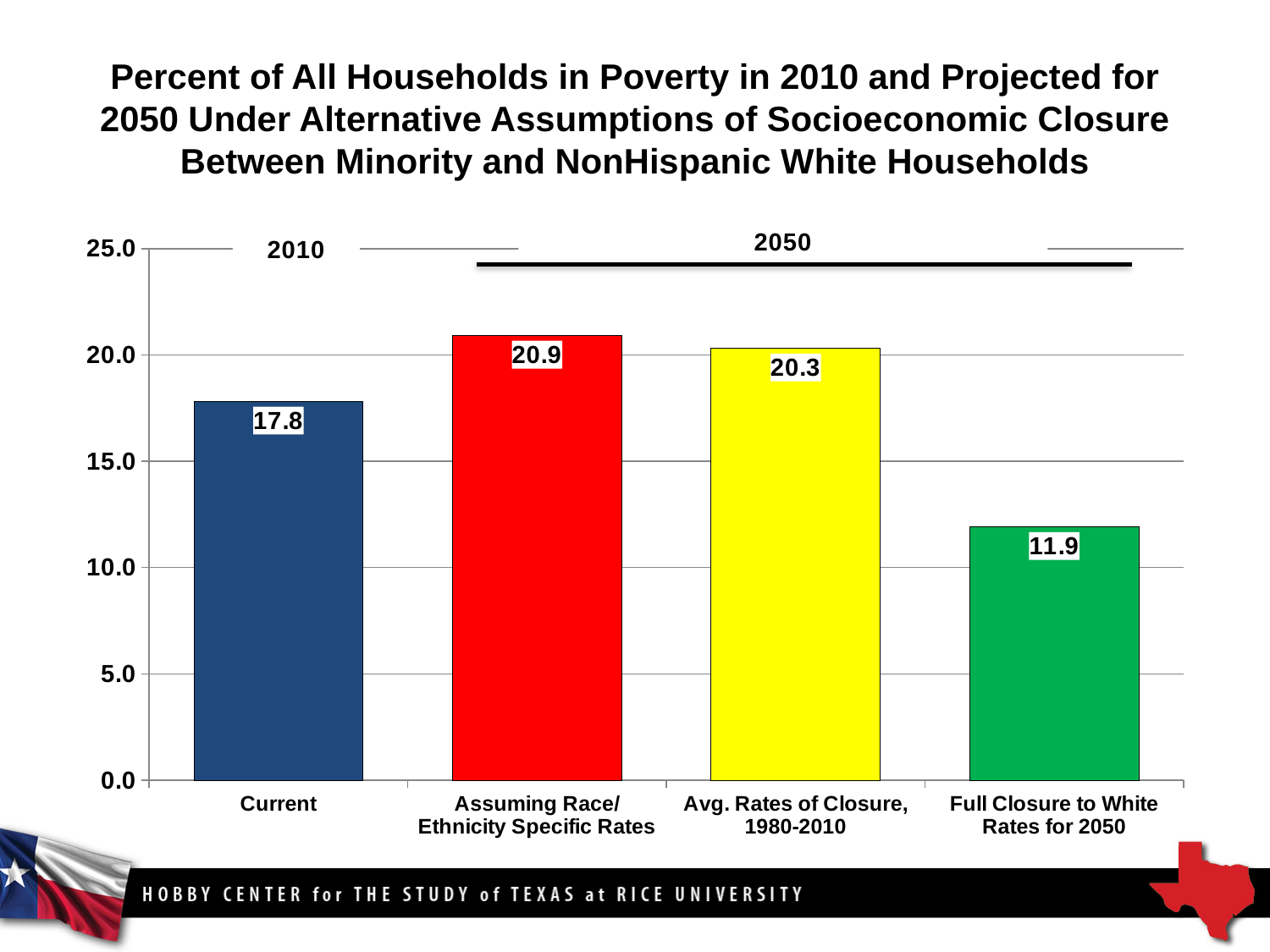
What is the difference between the Assuming Race/Ethnicity Specific Rates value and the Current value? 3.1 Is the value for Full Closure to White Rates for 2050 greater or less than 15.0? less What is the difference between the Avg. Rates of Closure, 1980-2010 value and the Full Closure to White Rates for 2050 value? 8.4 Which is larger: the value for Current or the value for Avg. Rates of Closure, 1980-2010? Avg. Rates of Closure, 1980-2010 What is the percent of households in poverty for the Current (2010) category? 17.8 What kind of chart is shown on the slide? Bar chart Which category has the lowest percent of households in poverty? Full Closure to White Rates for 2050 How many bars are shown in the chart? 4 What is the projected 2050 poverty percentage under the Assuming Race/Ethnicity Specific Rates scenario? 20.9 What colour is the bar for Avg. Rates of Closure, 1980-2010? Yellow What is the projected 2050 poverty percentage under Full Closure to White Rates for 2050? 11.9 Which category has the highest percent of households in poverty? Assuming Race/Ethnicity Specific Rates